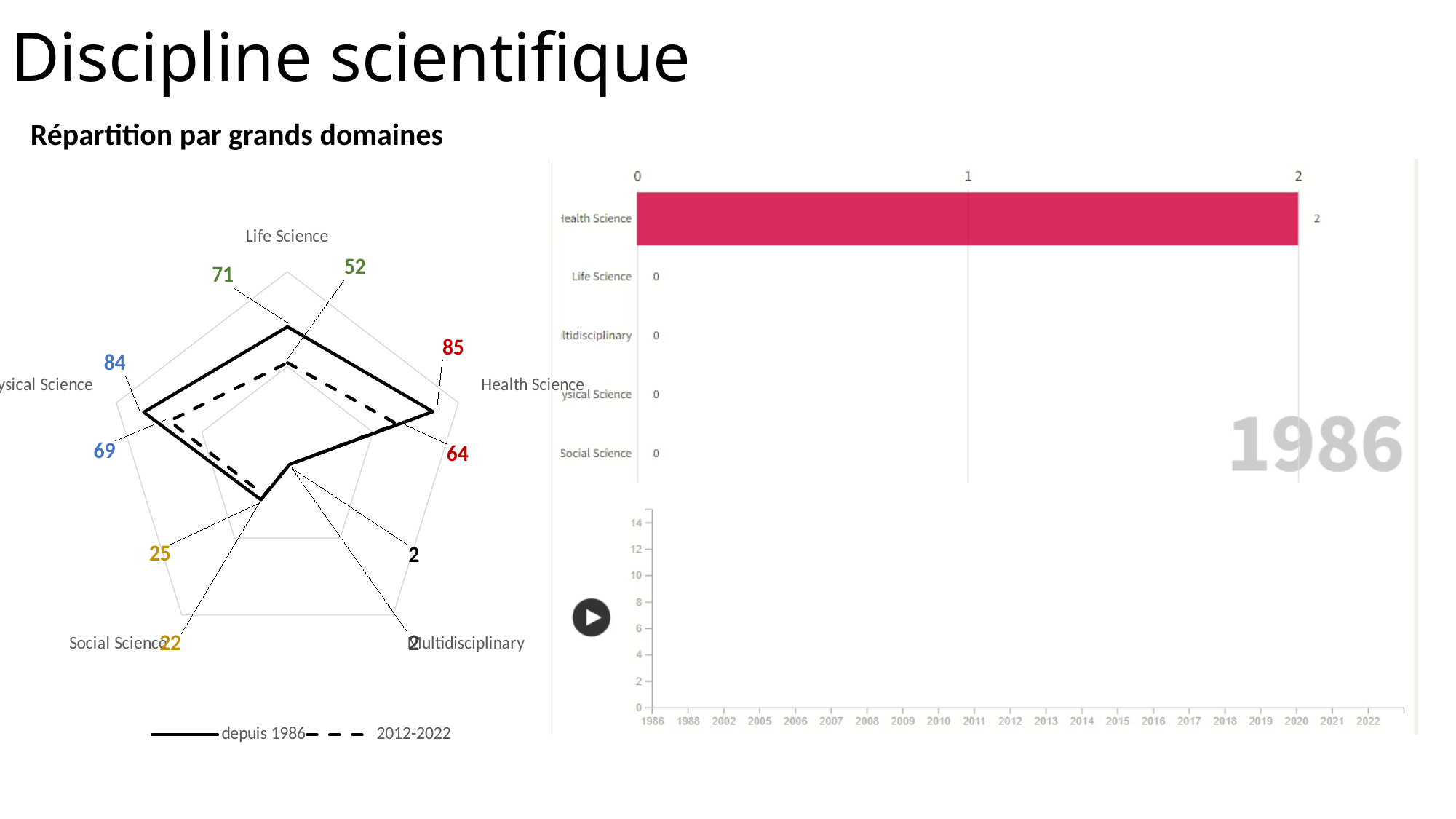
On the radar chart on the left, which is larger for Physical Science: the 'depuis 1986' value or the '2012-2022' value? depuis 1986 How many series does the legend of the radar chart on the left list? 2 On the radar chart on the left, which category has the highest value in the 'depuis 1986' series? Health Science On the radar chart on the left, what is the value for Life Science in the '2012-2022' series? 52 On the bar chart on the right, which category has the highest value? Health Science How many categories does the radar chart on the left have? 5 On the radar chart on the left, what is the value for Social Science in the 'depuis 1986' series? 25 On the bar chart on the right, what is the value for Health Science? 2 On the radar chart on the left, what is the difference between the 'depuis 1986' and '2012-2022' values for Life Science? 19 On the radar chart on the left, which category has the lowest value in the '2012-2022' series? Multidisciplinary On the radar chart on the left, what is the value for Health Science in the 'depuis 1986' series? 85 What kind of chart is the chart on the right showing Health Science, Life Science and other domains? bar chart